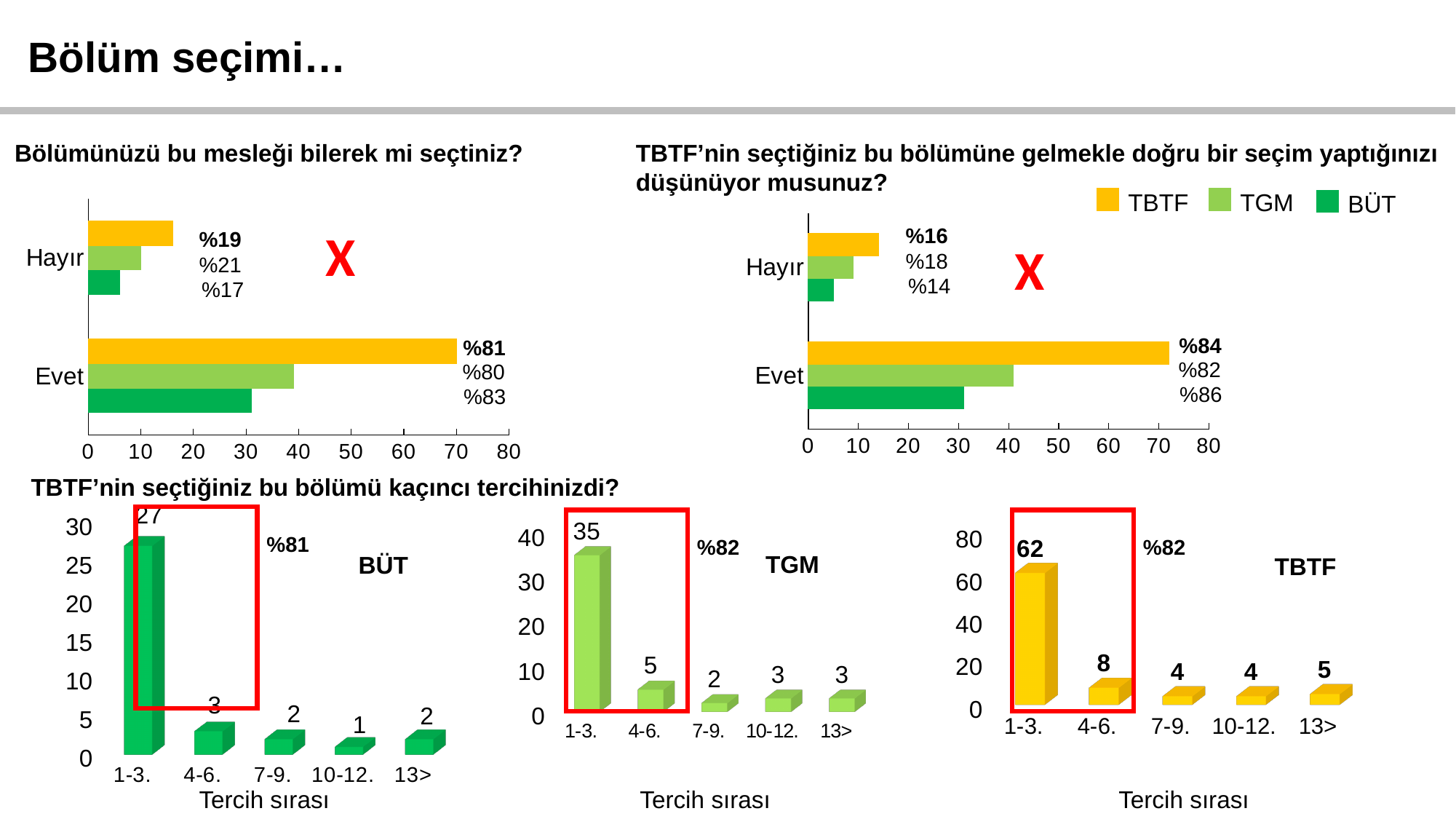
What kind of chart is the chart titled 'Bölümünüzü bu mesleği bilerek mi seçtiniz?'? Bar chart In the chart 'Bölümünüzü bu mesleği bilerek mi seçtiniz?', what is the BÜT value for Hayır? %17 How many series does the legend at the top right of the slide list? 3 In the TBTF chart under 'TBTF'nin seçtiğiniz bu bölümü kaçıncı tercihinizdi?', which category has the highest value? 1-3. In the TGM chart under 'TBTF'nin seçtiğiniz bu bölümü kaçıncı tercihinizdi?', what is the value for 4-6.? 5 How many categories are shown on the x axis of the TGM chart under 'TBTF'nin seçtiğiniz bu bölümü kaçıncı tercihinizdi?'? 5 In the BÜT chart under 'TBTF'nin seçtiğiniz bu bölümü kaçıncı tercihinizdi?', what is the value for 1-3.? 27 In the TBTF chart under 'TBTF'nin seçtiğiniz bu bölümü kaçıncı tercihinizdi?', what is the difference between the values for 1-3. and 4-6.? 54 In the chart 'Bölümünüzü bu mesleği bilerek mi seçtiniz?', what is the TBTF value for Evet? %81 In the chart 'TBTF'nin seçtiğiniz bu bölümüne gelmekle doğru bir seçim yaptığınızı düşünüyor musunuz?', what is the BÜT value for Evet? %86 In the BÜT chart under 'TBTF'nin seçtiğiniz bu bölümü kaçıncı tercihinizdi?', which category has the lowest value? 10-12. In the chart 'TBTF'nin seçtiğiniz bu bölümüne gelmekle doğru bir seçim yaptığınızı düşünüyor musunuz?', which series has the lowest value for Hayır? BÜT